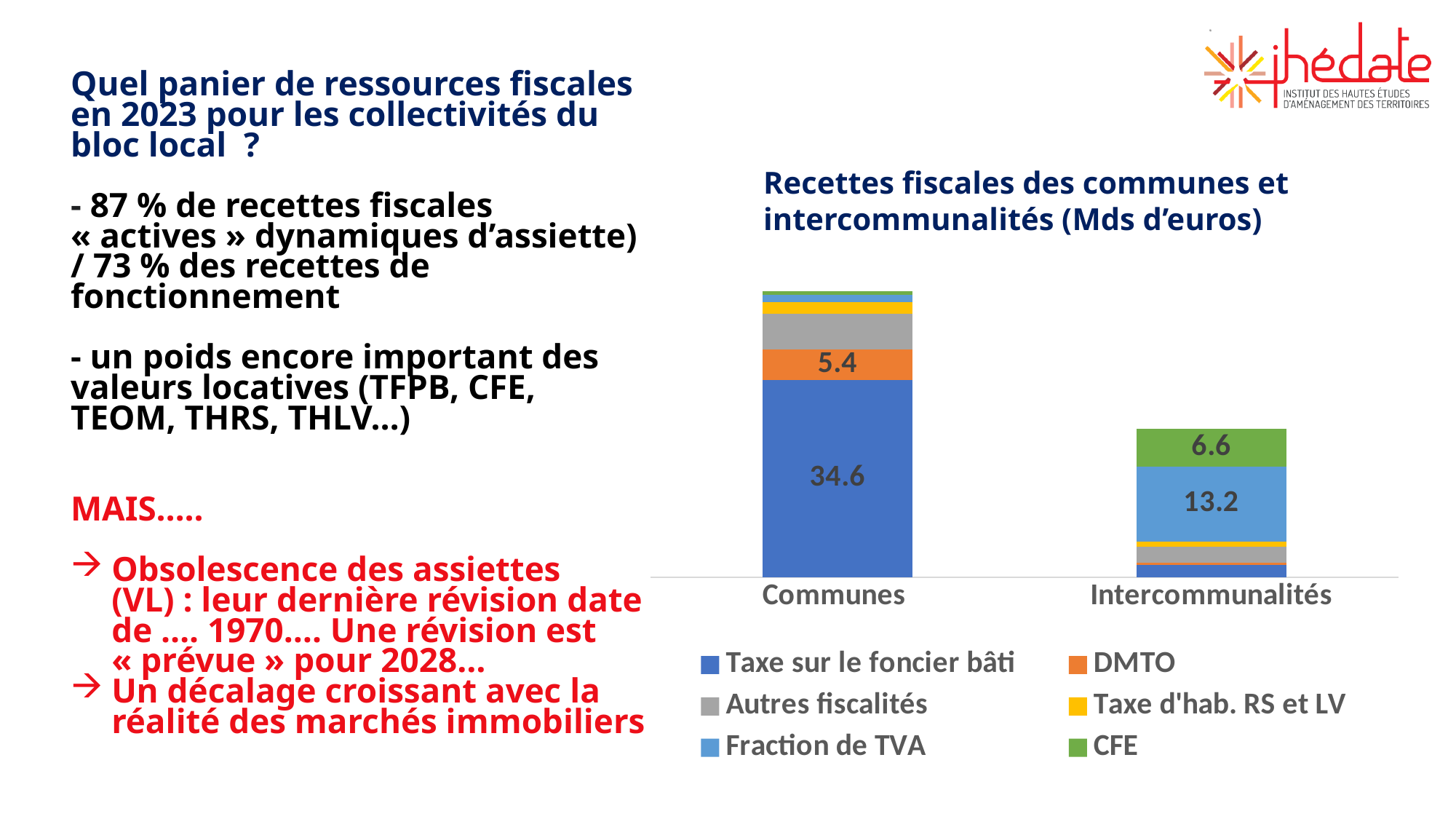
How many series does the legend list? 6 Which is larger: Taxe sur le foncier bâti for Communes or Fraction de TVA for Intercommunalités? Taxe sur le foncier bâti for Communes What is the value of DMTO for Communes? 5.4 What is the value of Taxe sur le foncier bâti for Communes? 34.6 How many categories are shown on the x axis? 2 What is the title of the chart? Recettes fiscales des communes et intercommunalités (Mds d'euros) What is the difference between Taxe sur le foncier bâti and DMTO for Communes? 29.2 Which category has the taller stacked bar overall? Communes What kind of chart is shown on the slide? Stacked bar chart What is the difference between Fraction de TVA and CFE for Intercommunalités? 6.6 What is the value of CFE for Intercommunalités? 6.6 What is the value of Fraction de TVA for Intercommunalités? 13.2